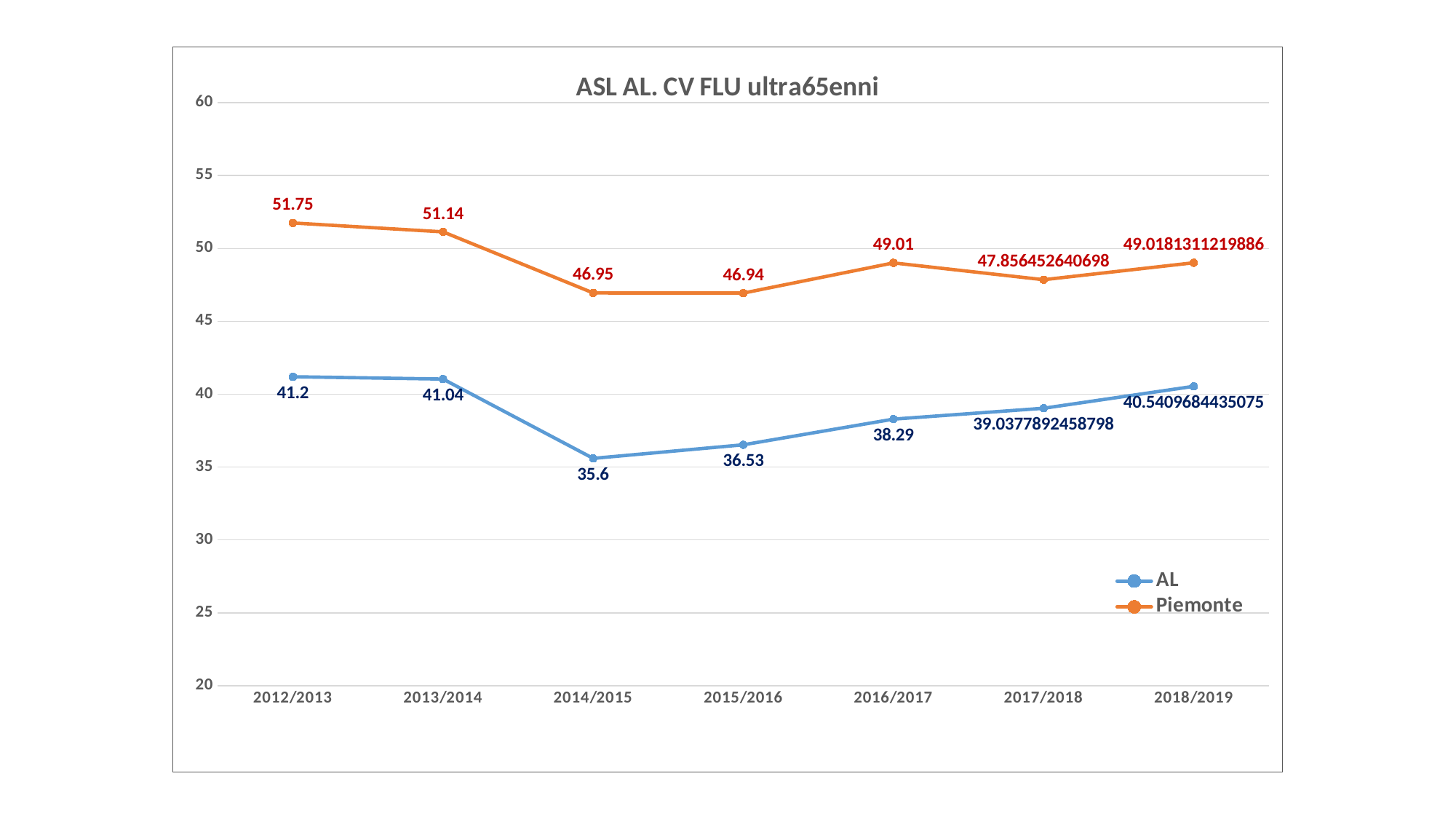
What kind of chart is this? line chart What is the value for AL in 2014/2015? 35.6 How many series does the legend list? 2 In which season is the AL series lowest? 2014/2015 What is the difference between the AL values in 2012/2013 and 2013/2014? 0.16 Which is larger in 2015/2016, AL or Piemonte? Piemonte What is the difference between Piemonte and AL in 2012/2013? 10.55 What is the value for Piemonte in 2016/2017? 49.01 What is the value for Piemonte in 2012/2013? 51.75 What is the value for AL in 2015/2016? 36.53 In which season is the Piemonte series highest? 2012/2013 How many seasons are shown on the x axis? 7